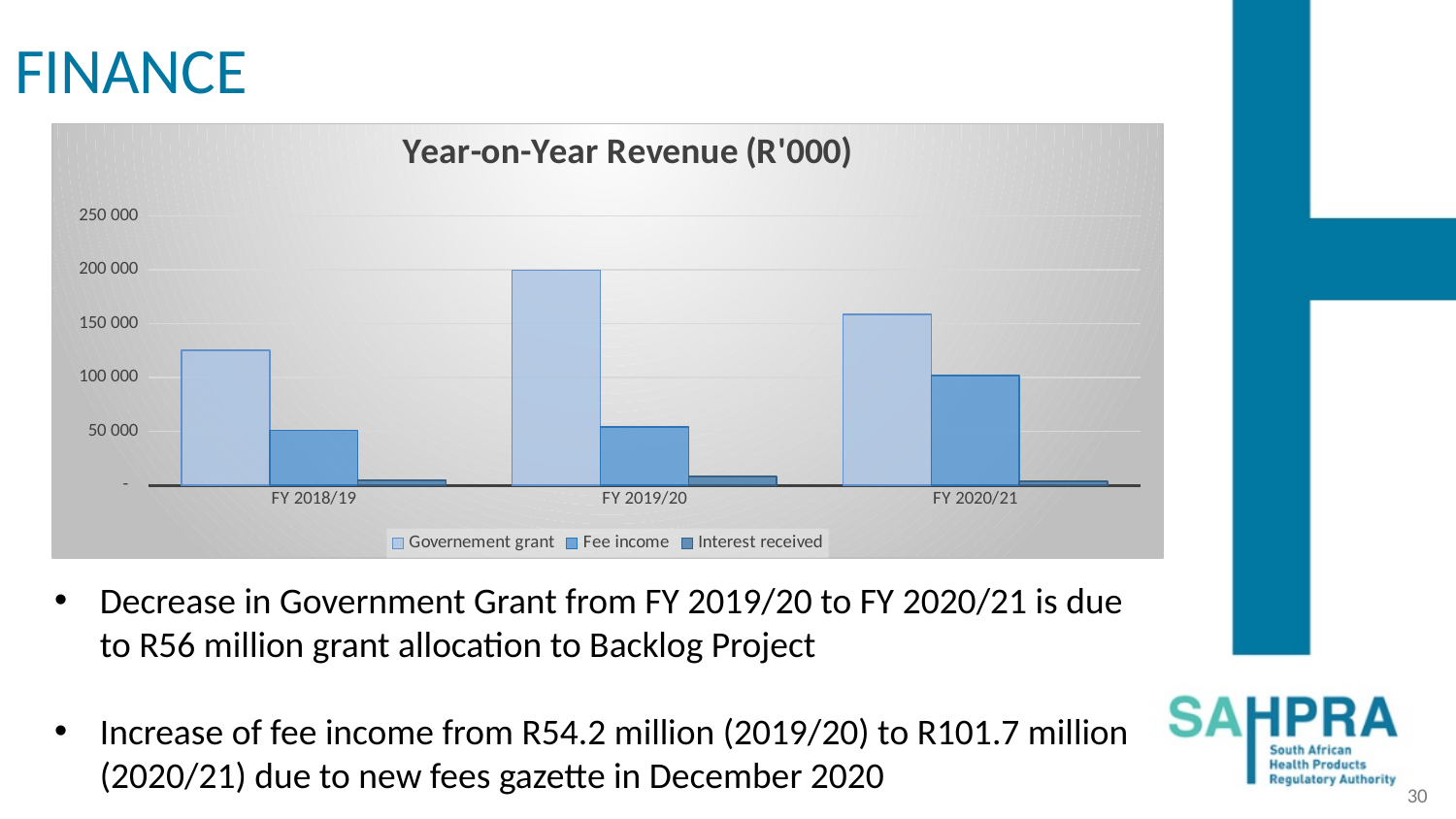
In which fiscal year is Fee income highest? FY 2020/21 How many series does the chart legend list? 3 Is the Fee income for FY 2020/21 greater or less than 150 000? less In which fiscal year is the Governement grant highest? FY 2019/20 In FY 2020/21, which is larger: Governement grant or Fee income? Governement grant How many fiscal years are shown on the x axis of the chart? 3 Is the Governement grant for FY 2018/19 greater or less than 100 000? greater Is the Interest received for FY 2019/20 greater or less than 50 000? less What is the title of the chart? Year-on-Year Revenue (R'000) In which fiscal year is the Governement grant lowest? FY 2018/19 Which is larger: the Governement grant in FY 2018/19 or in FY 2020/21? FY 2020/21 What type of chart is shown on the slide? Bar chart